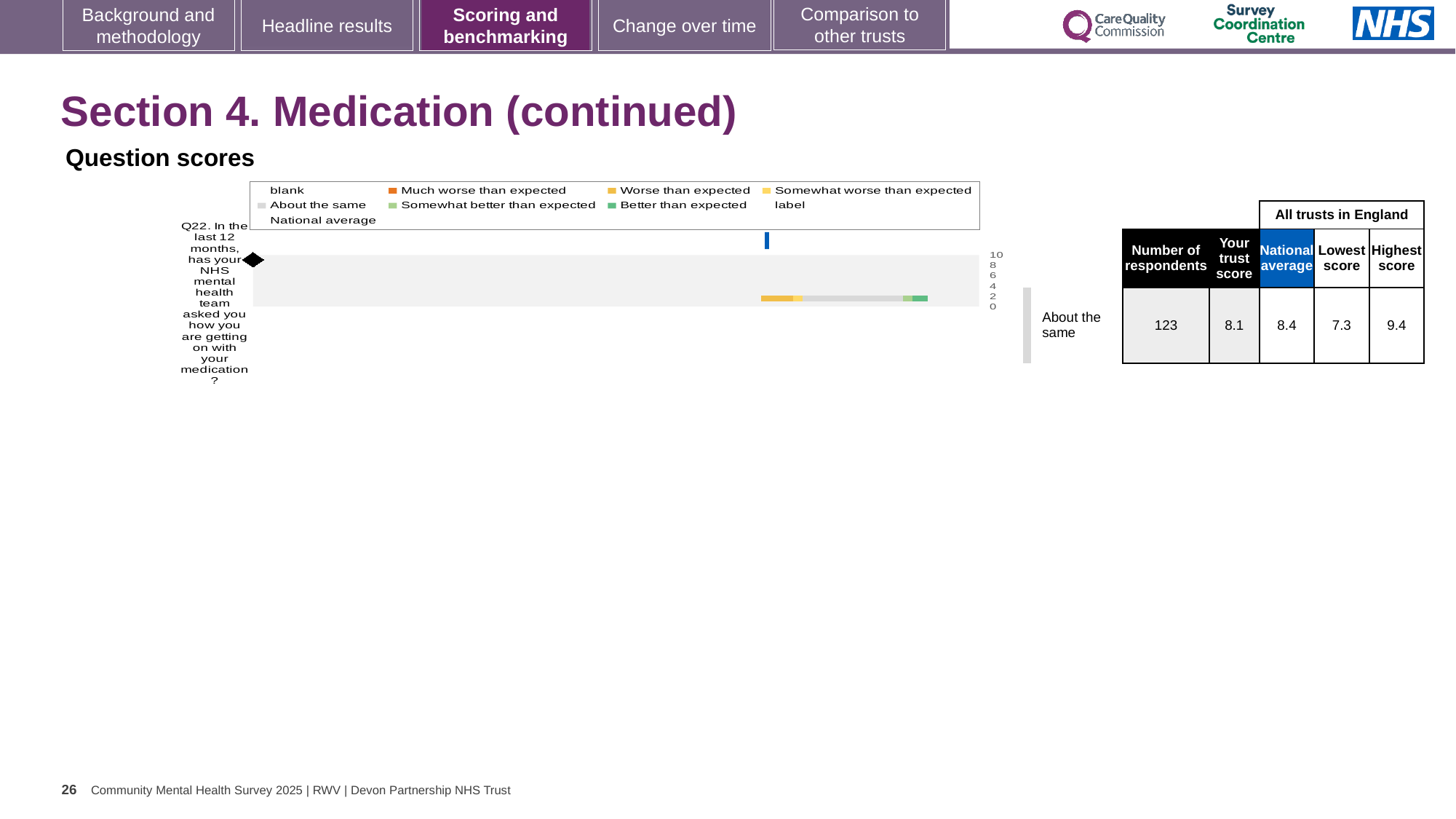
Which is larger for Q22, the trust score or the national average? national average What is the national average score for Q22? 8.4 What kind of chart is shown on the slide? bar chart How many respondents answered Q22? 123 What is the difference between the highest score and the lowest score for Q22? 2.1 How many survey questions are plotted on the chart? 1 Which benchmarking category does the trust's Q22 score fall into? About the same Which question is plotted on the chart? Q22. In the last 12 months, has your NHS mental health team asked you how you are getting on with your medication? What is the trust score for Q22? 8.1 What is the lowest score among all trusts in England for Q22? 7.3 What is the highest score among all trusts in England for Q22? 9.4 What is the maximum value shown on the chart's score axis? 10